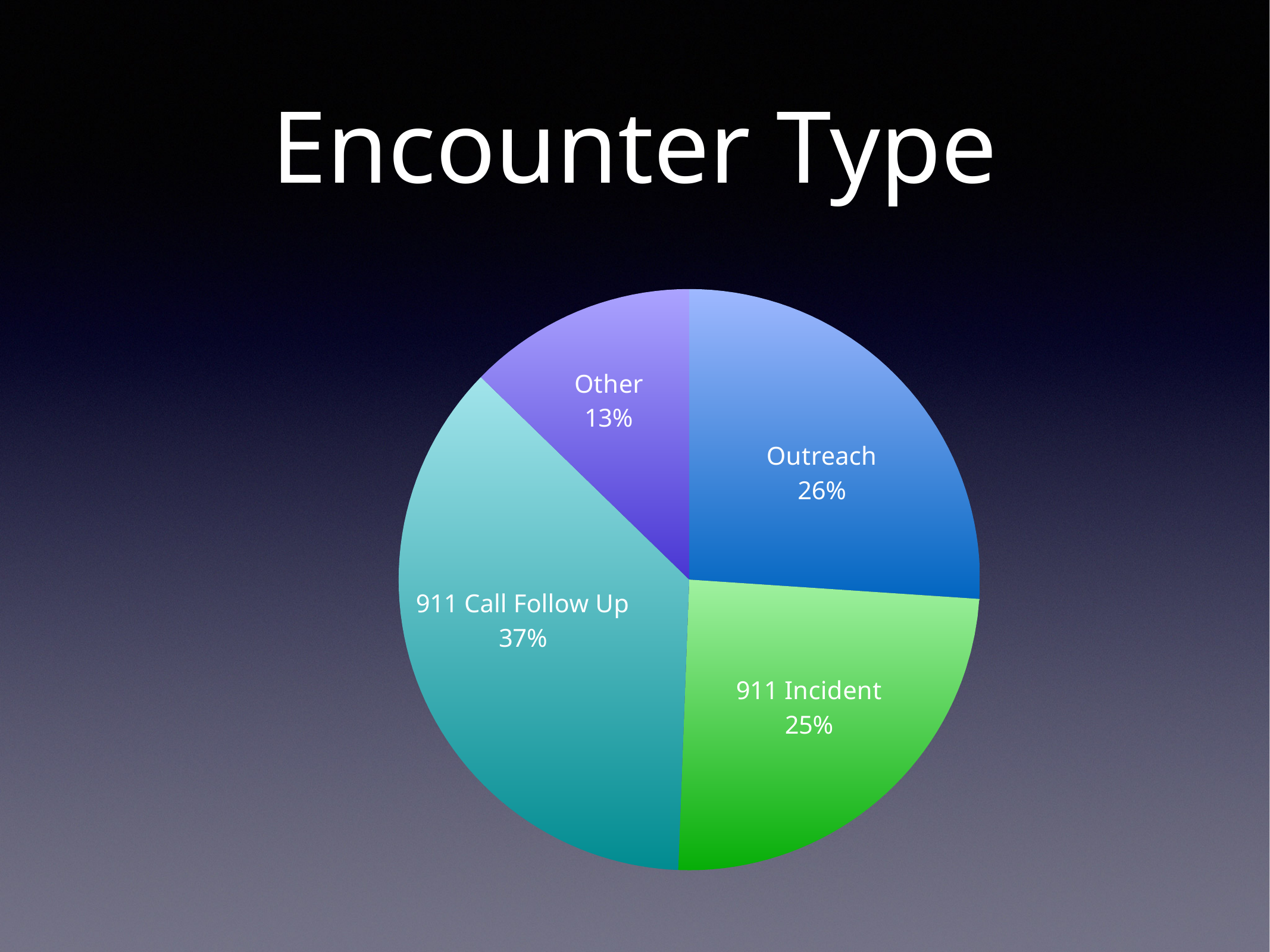
What is the value shown for Outreach? 26% Which encounter type has the largest slice? 911 Call Follow Up Which encounter type has the smallest slice? Other How many slices does the pie chart have? 4 What share of the pie does Other represent? 13% What share of the pie does 911 Call Follow Up represent? 37% What is the difference in percentage points between Outreach and 911 Incident? 1 What is the title of the slide? Encounter Type What kind of chart is shown on the slide? Pie chart What is the difference in percentage points between 911 Call Follow Up and Other? 24 Which is larger, 911 Call Follow Up or Outreach? 911 Call Follow Up What is the value shown for 911 Incident? 25%